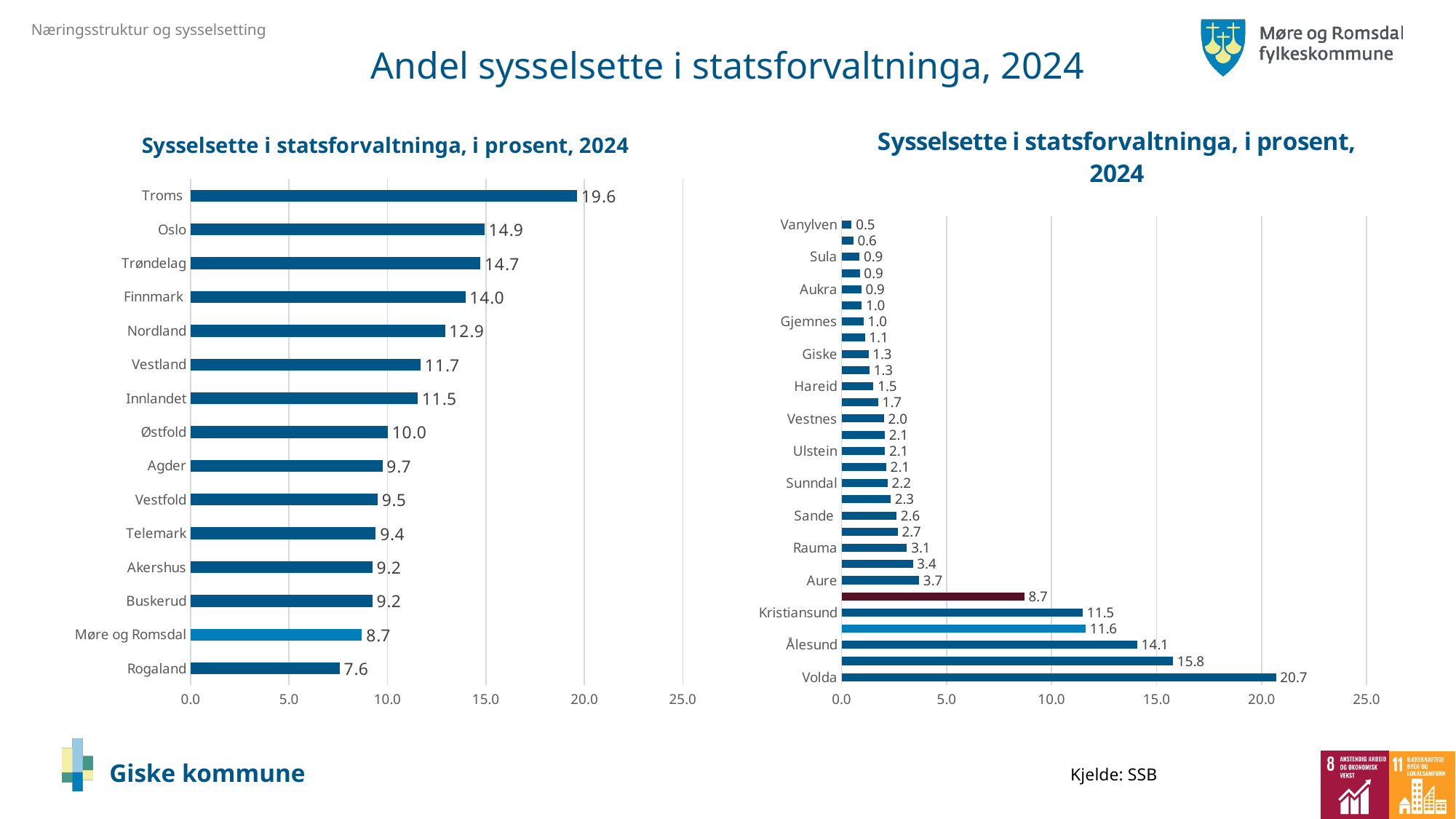
On the left chart, which county has the highest value? Troms On the left chart, what is the difference between Oslo and Rogaland? 7.3 On the left chart, what is the value for Troms? 19.6 On the right chart, what is the difference between Ålesund and Kristiansund? 2.6 On the right chart, what is the value for Giske? 1.3 On the left chart, which is larger, Nordland or Vestland? Nordland On the left chart, what is the value for Møre og Romsdal? 8.7 On the left chart, which county has the lowest share of employees in state administration? Rogaland What type of chart is the left chart? Bar chart On the right chart, what is the value for Volda? 20.7 How many counties are shown on the left chart? 15 On the right chart, which municipality has the highest value? Volda